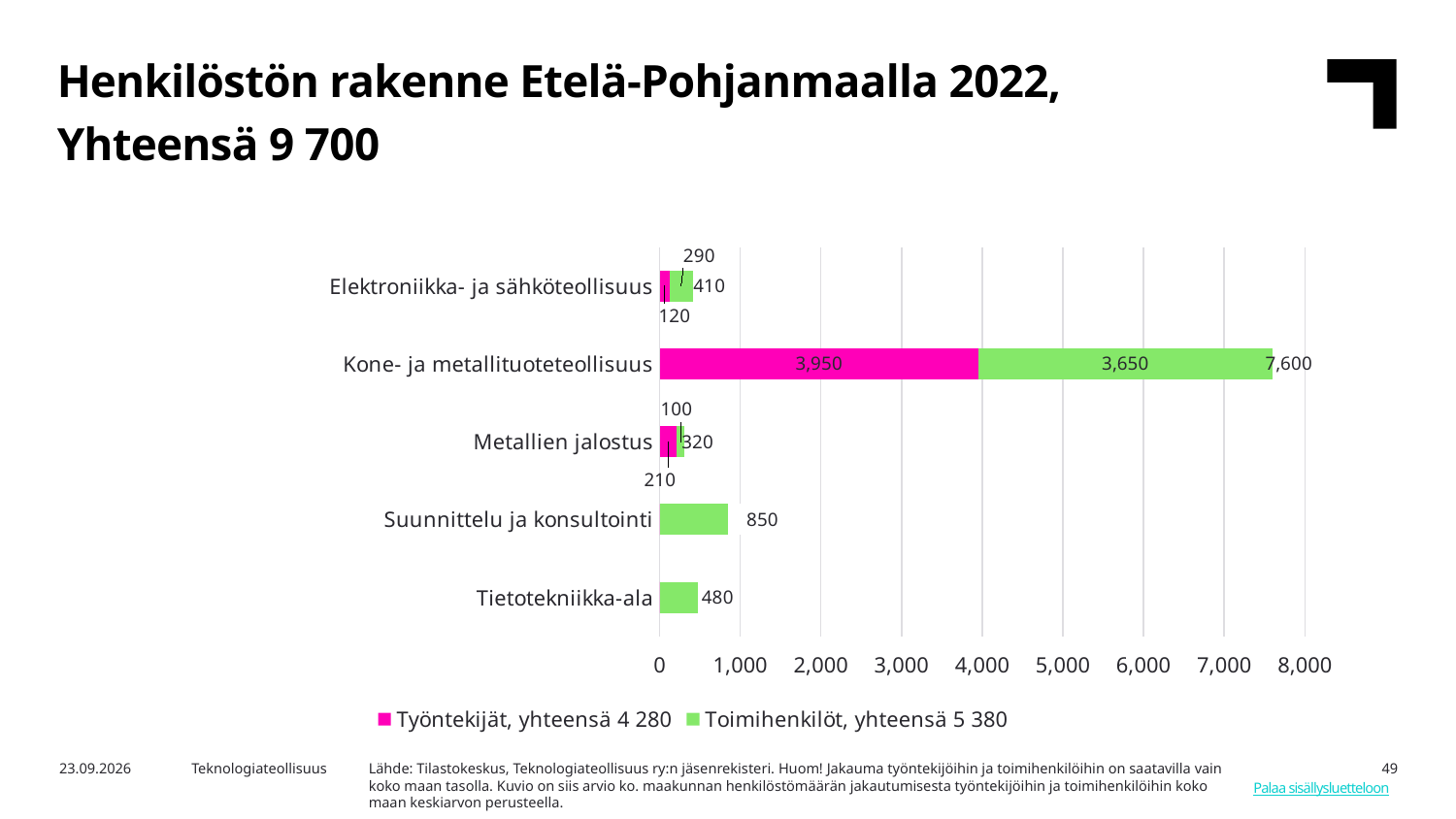
Which category has the highest total? Kone- ja metallituoteteollisuus Which is larger: the total for Elektroniikka- ja sähköteollisuus or the total for Metallien jalostus? Elektroniikka- ja sähköteollisuus What is the value for Toimihenkilöt in Kone- ja metallituoteteollisuus? 3,650 According to the legend, what is the total for Toimihenkilöt? 5 380 What type of chart is shown on the slide? Stacked bar chart How many series does the legend list? 2 What is the value for Toimihenkilöt in Suunnittelu ja konsultointi? 850 What is the total of the stacked bar for Kone- ja metallituoteteollisuus? 7,600 What is the value for Toimihenkilöt in Tietotekniikka-ala? 480 What is the difference between the Työntekijät and Toimihenkilöt values in Kone- ja metallituoteteollisuus? 300 How many categories are shown on the chart? 5 What is the value for Työntekijät in Kone- ja metallituoteteollisuus? 3,950